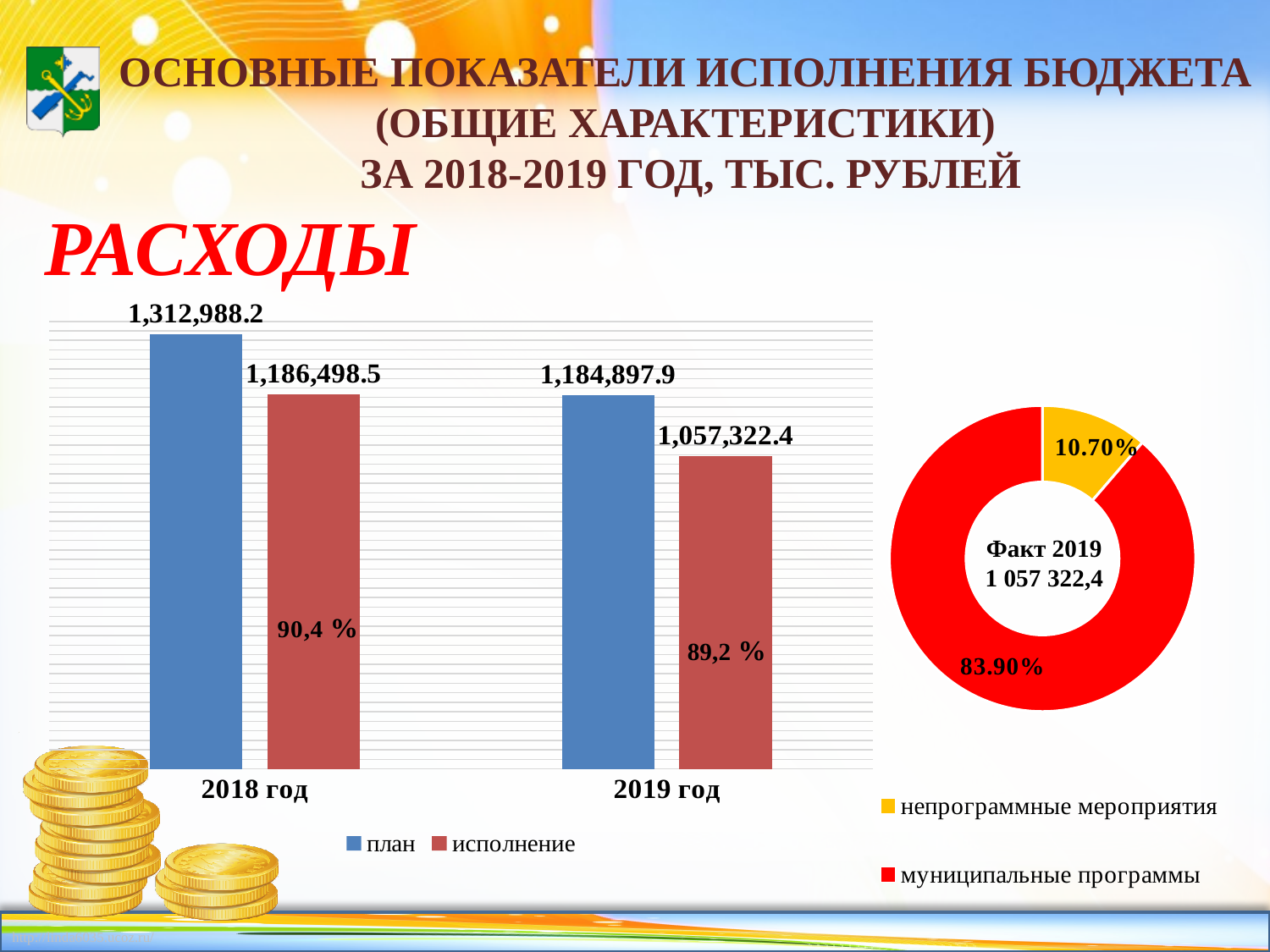
In the doughnut chart on the right, what share is shown for непрограммные мероприятия? 10.70% In the bar chart on the left, does the план value rise or fall from 2018 год to 2019 год? fall In the bar chart on the left, what is the value of план for 2018 год? 1,312,988.2 In the bar chart on the left, what is the value of план for 2019 год? 1,184,897.9 In the bar chart on the left, what is the difference between план and исполнение for 2018 год? 126,489.7 In the bar chart on the left, what is the value of исполнение for 2019 год? 1,057,322.4 In the bar chart on the left, which bar is the lowest? исполнение, 2019 год In the bar chart on the left, what percentage label is shown on the исполнение bar for 2018 год? 90,4 % In the bar chart on the left, which is larger: план for 2019 год or исполнение for 2018 год? исполнение for 2018 год In the doughnut chart on the right, what text is shown in the centre of the ring? Факт 2019 1 057 322,4 In the bar chart on the left, which bar is the highest? план, 2018 год In the bar chart on the left, how many series does the legend list? 2